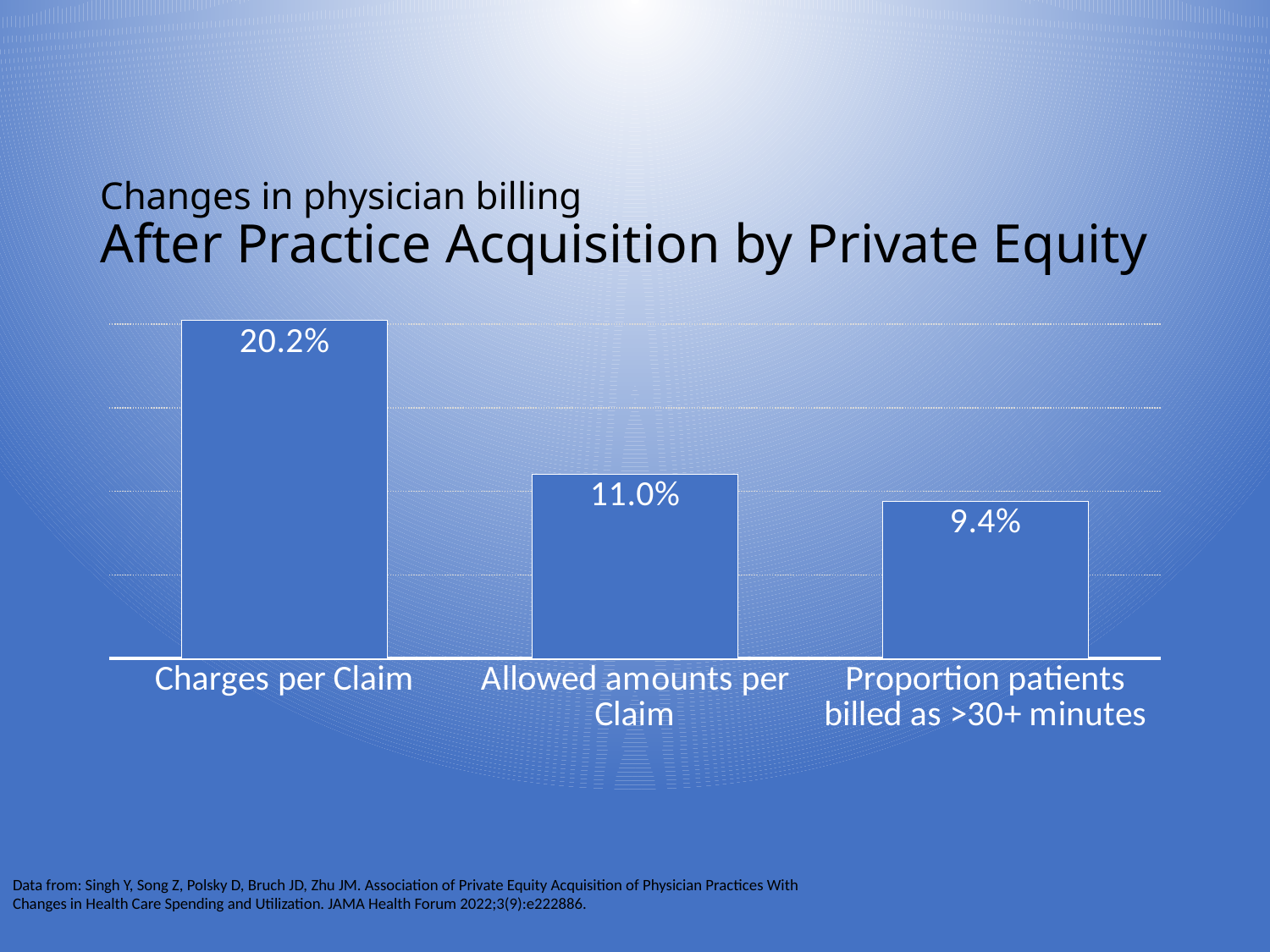
What is the value for Charges per Claim? 20.2% What is the value for Proportion patients billed as >30+ minutes? 9.4% How many categories are shown in the chart? 3 Which category has the highest value? Charges per Claim Do the values rise or fall from left to right across the categories? Fall What is the difference between the values for Allowed amounts per Claim and Proportion patients billed as >30+ minutes? 1.6% What kind of chart is shown on the slide? Bar chart What is the title of the slide containing the chart? Changes in physician billing After Practice Acquisition by Private Equity Which is larger, the value for Charges per Claim or the value for Proportion patients billed as >30+ minutes? Charges per Claim What is the value for Allowed amounts per Claim? 11.0% What is the difference between the values for Charges per Claim and Allowed amounts per Claim? 9.2% Which category has the lowest value? Proportion patients billed as >30+ minutes